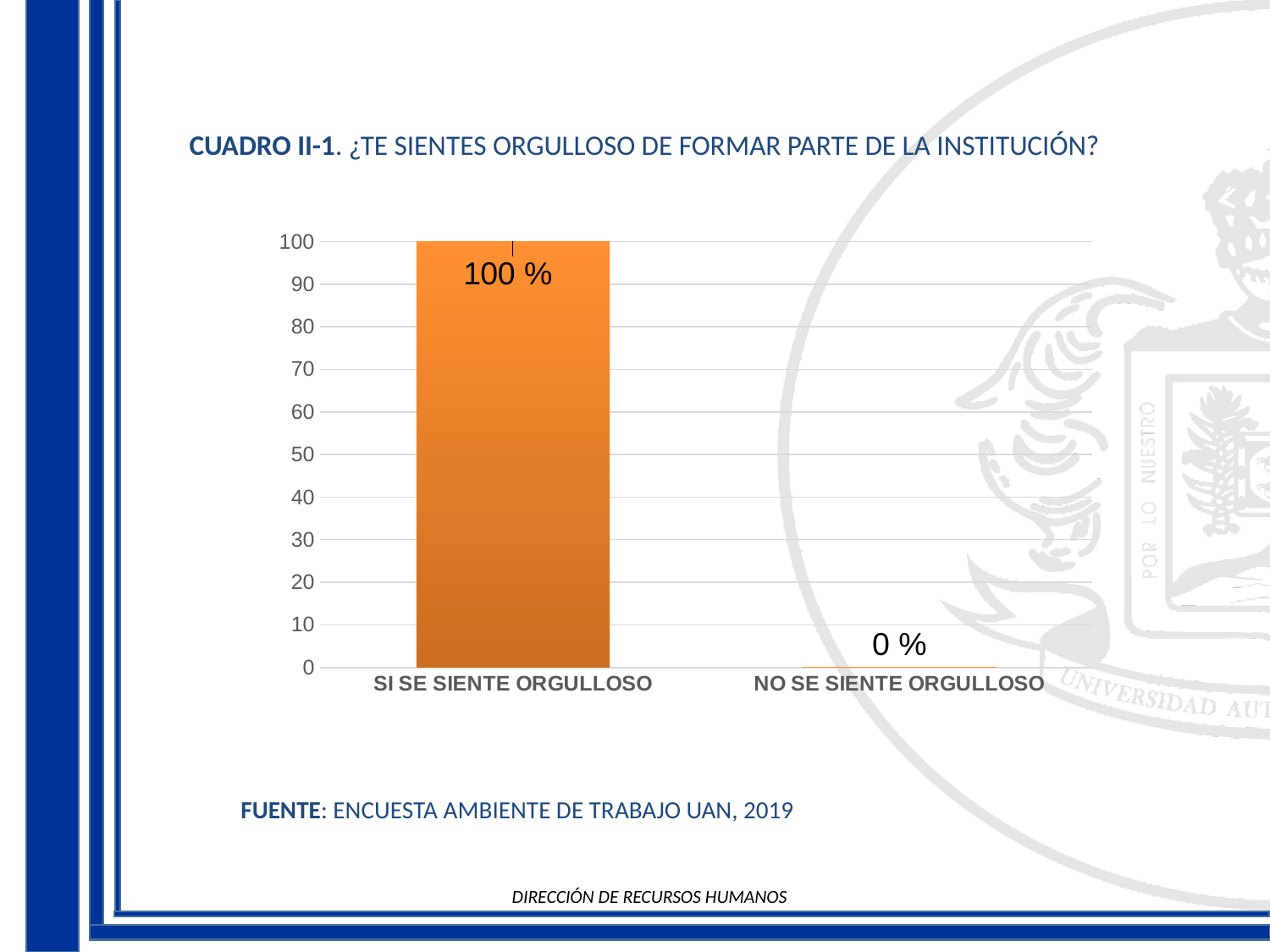
What is the source cited below the chart? ENCUESTA AMBIENTE DE TRABAJO UAN, 2019 Which is larger, the value for SI SE SIENTE ORGULLOSO or NO SE SIENTE ORGULLOSO? SI SE SIENTE ORGULLOSO What is the title of the chart (CUADRO II-1)? ¿TE SIENTES ORGULLOSO DE FORMAR PARTE DE LA INSTITUCIÓN? Which category has the lowest value? NO SE SIENTE ORGULLOSO What kind of chart is shown on the slide? bar chart What is the value for NO SE SIENTE ORGULLOSO? 0 % What is the difference between the values for SI SE SIENTE ORGULLOSO and NO SE SIENTE ORGULLOSO? 100 % Do the values rise or fall from left to right along the x axis? fall What is the value for SI SE SIENTE ORGULLOSO? 100 % Which category has the highest value? SI SE SIENTE ORGULLOSO Is the value for SI SE SIENTE ORGULLOSO greater or less than 50? greater How many categories are shown on the x axis? 2